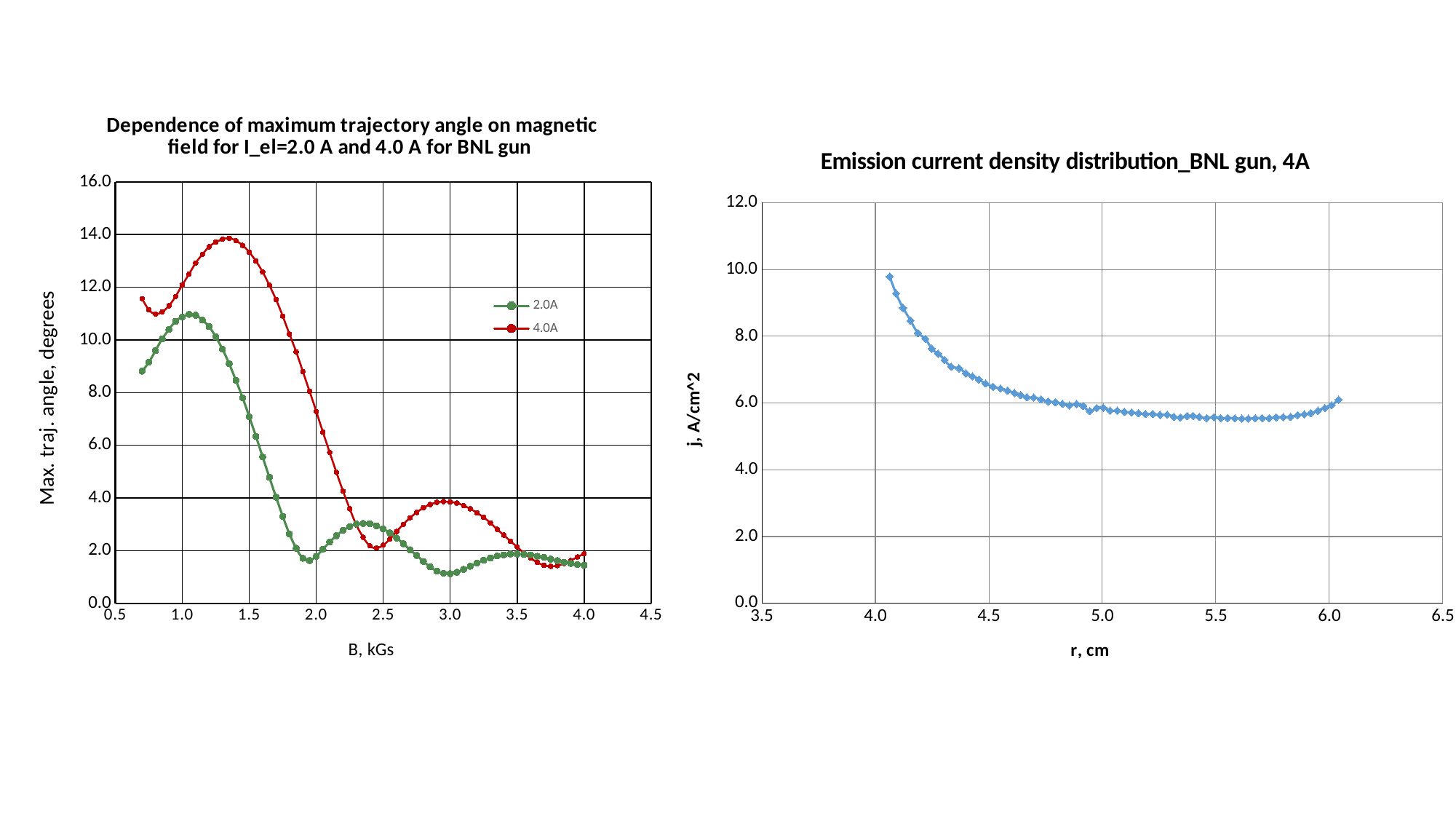
How many series does the legend of the left chart list? 2 In the left chart, is the value of the 4.0A series at B = 3.0 kGs greater or less than 2.0 degrees? greater In the right chart 'Emission current density distribution_BNL gun, 4A', what is the label of the y axis? j, A/cm^2 In the right chart 'Emission current density distribution_BNL gun, 4A', is the value of j at r = 4.5 cm greater or less than 6.0 A/cm^2? greater In the left chart, at B = 1.5 kGs, which series has the larger value, 2.0A or 4.0A? 4.0A In the right chart 'Emission current density distribution_BNL gun, 4A', is the value of j at r = 5.5 cm greater or less than 6.0 A/cm^2? less In the left chart, which series reaches the higher peak value, 2.0A or 4.0A? 4.0A In the right chart 'Emission current density distribution_BNL gun, 4A', does the current density rise or fall as r increases from 4.0 cm to 5.5 cm? fall In the left chart, what is the label of the x axis? B, kGs What type of chart is the left chart titled 'Dependence of maximum trajectory angle on magnetic field'? line chart